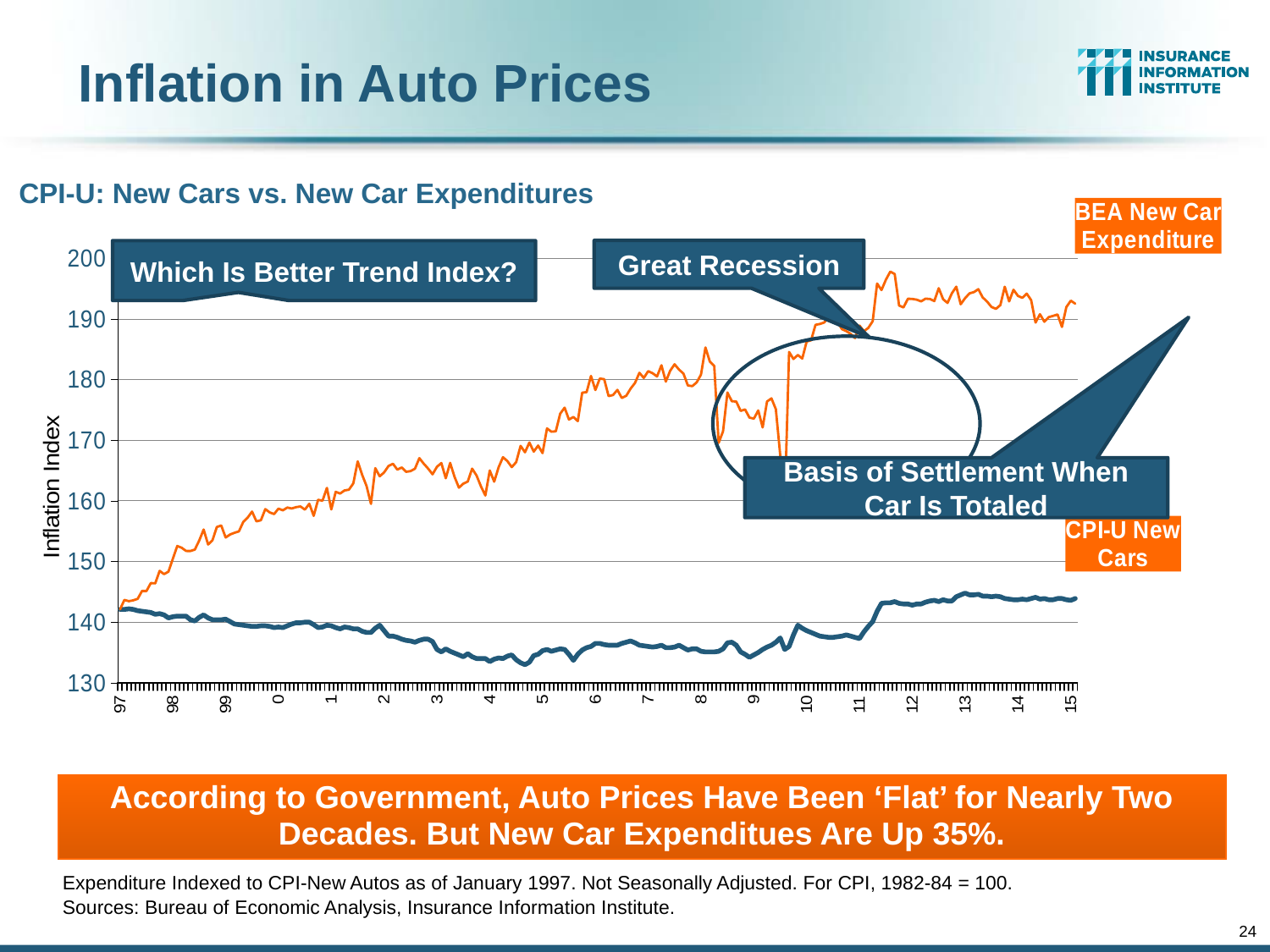
Is the value of the CPI-U New Cars series in 2015 greater or less than 150? less Is the value of the BEA New Car Expenditure series in 2007 greater or less than 170? greater Does the CPI-U New Cars series rise or fall from 1997 to 2004? fall Does the BEA New Car Expenditure series generally rise or fall from 1997 to 2015? rise What is the title of the chart? CPI-U: New Cars vs. New Car Expenditures What is the label on the vertical axis of the chart? Inflation Index Is the value of the BEA New Car Expenditure series in 2013 greater or less than 190? greater Which series is higher in 2015, BEA New Car Expenditure or CPI-U New Cars? BEA New Car Expenditure How many data series are plotted on the chart? 2 What kind of chart is shown on the slide? line chart